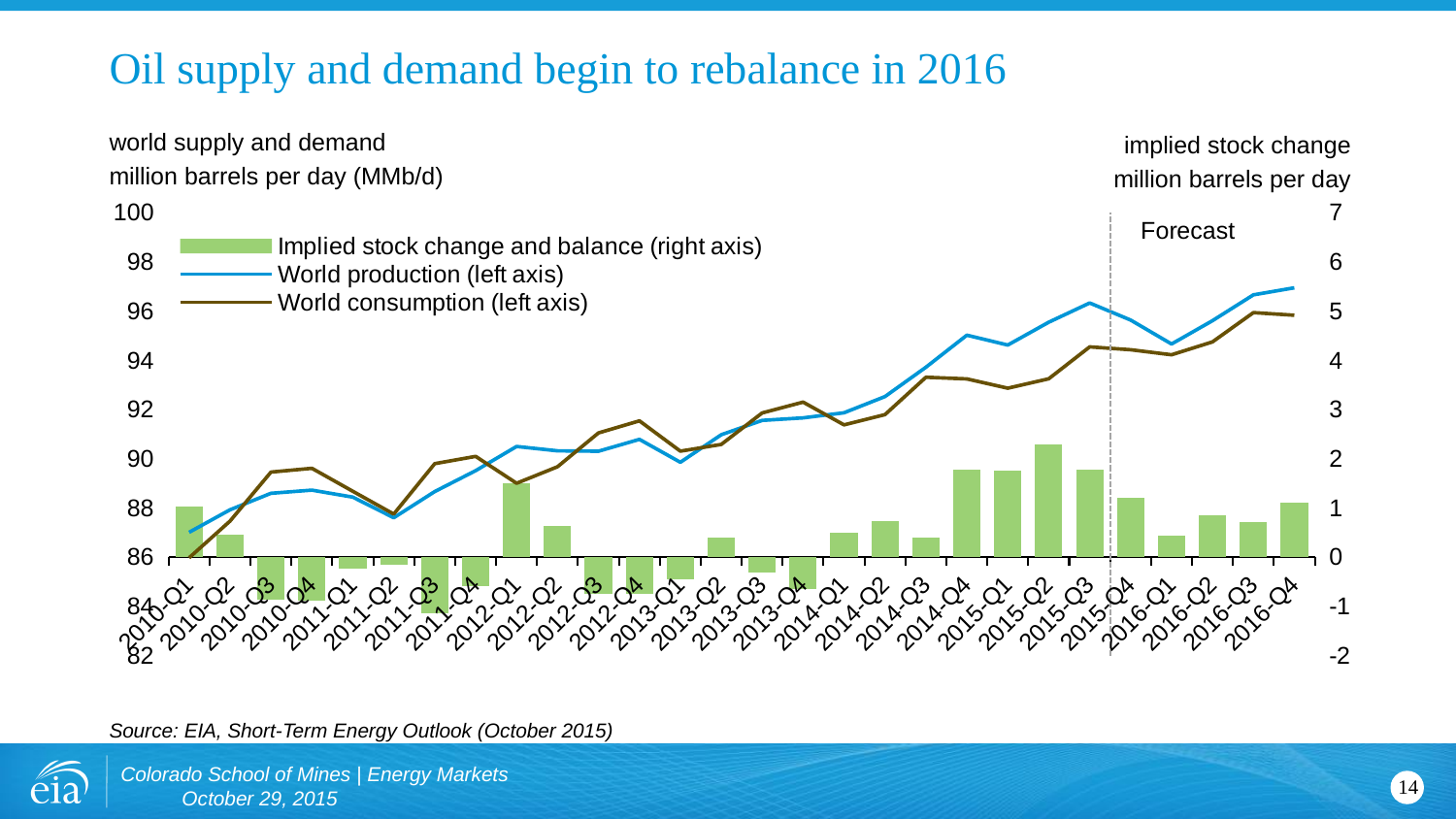
Is the world production value for 2016-Q4 greater or less than 96 MMb/d? greater In 2013-Q4, which is higher: world production or world consumption? World consumption Is the implied stock change for 2014-Q4 greater or less than 1 million barrels per day? greater In which quarter is the implied stock change bar the highest? 2015-Q2 Is the world consumption value for 2015-Q3 greater or less than 92 MMb/d? greater Does world production generally rise or fall from 2010-Q1 to 2016-Q4? Rise Which series is plotted as bars in the chart? Implied stock change and balance (right axis) What kind of chart is shown on the slide? Combined bar and line chart In 2016-Q4, which is higher: world production or world consumption? World production From which quarter onward does the chart mark the data as a forecast? 2015-Q4 How many series does the chart legend list? 3 How many quarters are shown along the x axis of the chart? 28